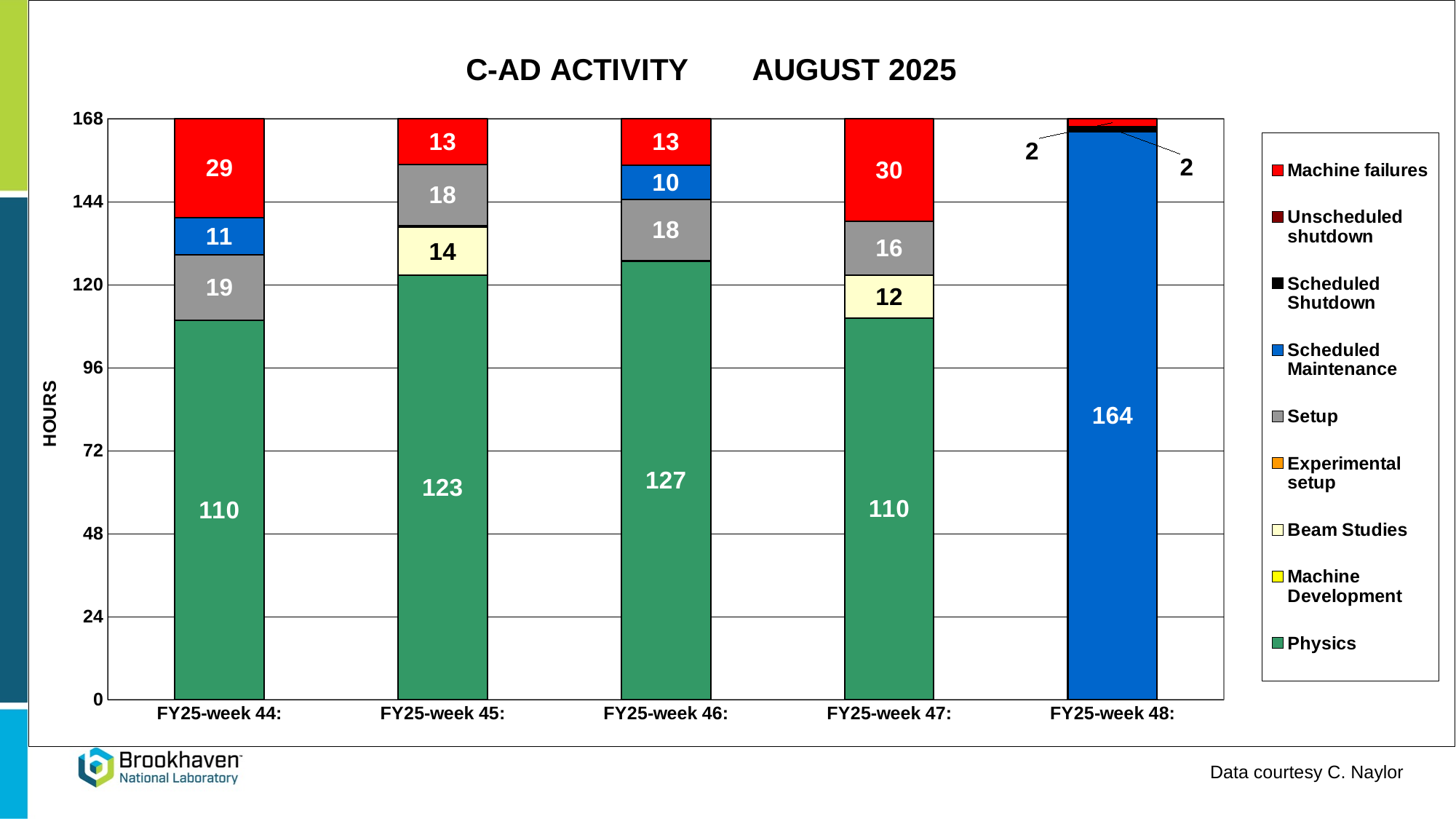
What is the Machine failures value for FY25-week 47? 30 How many weeks are shown on the x axis? 5 Which week has the highest Physics value? FY25-week 46 How many hours of Physics are shown for FY25-week 46? 127 What is the total of the stacked bar for FY25-week 45? 168 How many series does the legend list? 9 Which has the larger Setup value, FY25-week 44 or FY25-week 45? FY25-week 44 Which week has the lowest Machine failures value? FY25-week 48 How many hours of Beam Studies are shown for FY25-week 47? 12 What is the difference between the Machine failures values for FY25-week 47 and FY25-week 44? 1 What is the Scheduled Maintenance value for FY25-week 48? 164 What kind of chart is shown on the slide? Stacked bar chart